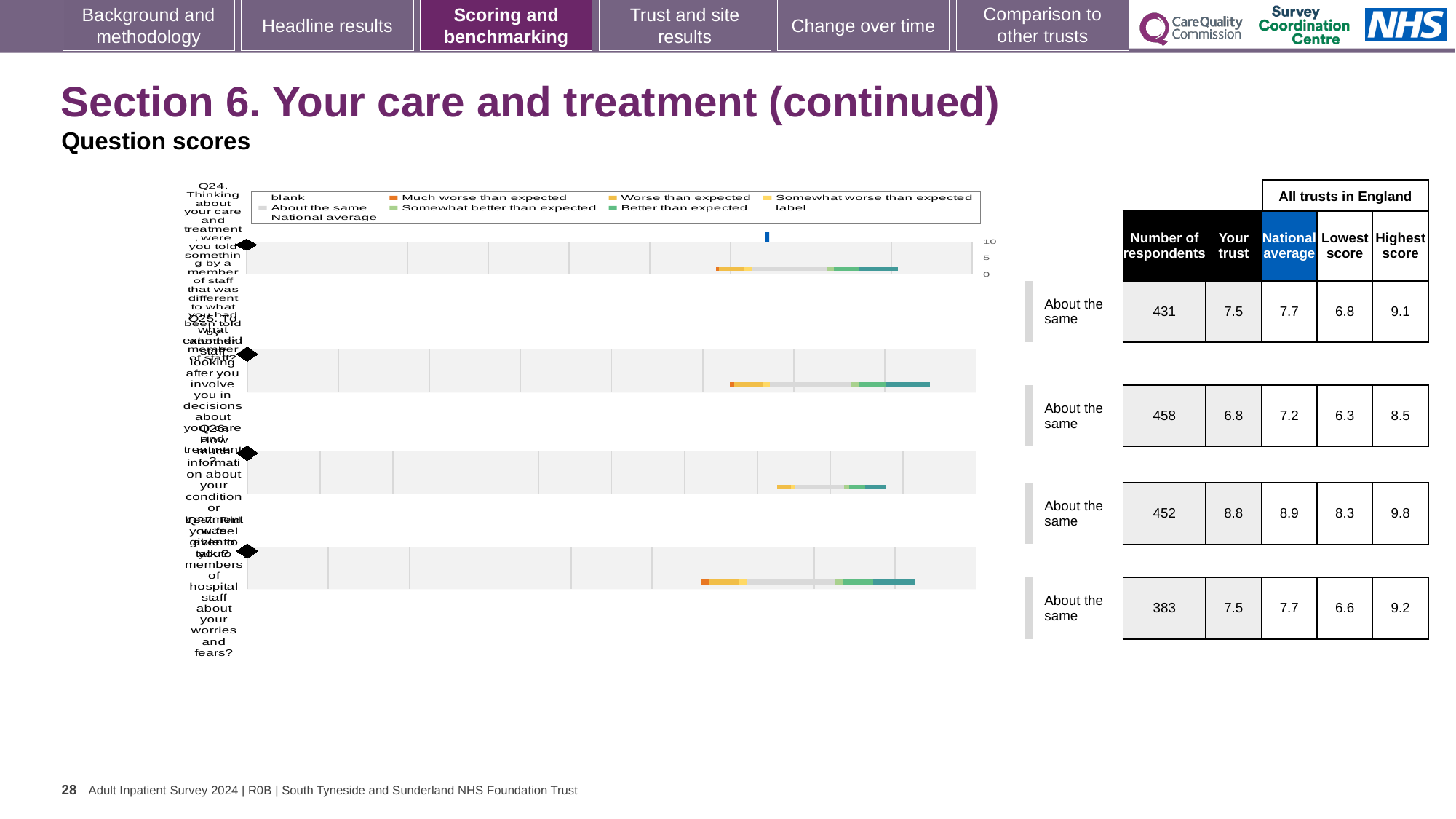
Which of the four charts has the lowest number of respondents? The bottom chart (Q27) What kind of chart is used for the question scores on this slide? bar chart For the bottom chart (Q27, about worries and fears), what is the national average score? 7.7 How many question charts are shown on the slide? 4 Is the 'Your trust' score for the top chart (Q24) greater or less than 5 on the axis? greater What benchmark category is shown next to each of the four charts? About the same For the second chart (Q25), which is larger: the 'Your trust' score or the national average? National average For the top chart (Q24), what is the 'Your trust' score shown in the table? 7.5 Which of the four charts has the highest 'Your trust' score? The third chart (Q26) For the third chart (Q26), what is the difference between the highest score and the lowest score? 1.5 How many respondents are listed for the second chart (Q25)? 458 In the legend, what colour represents 'Better than expected'? Green